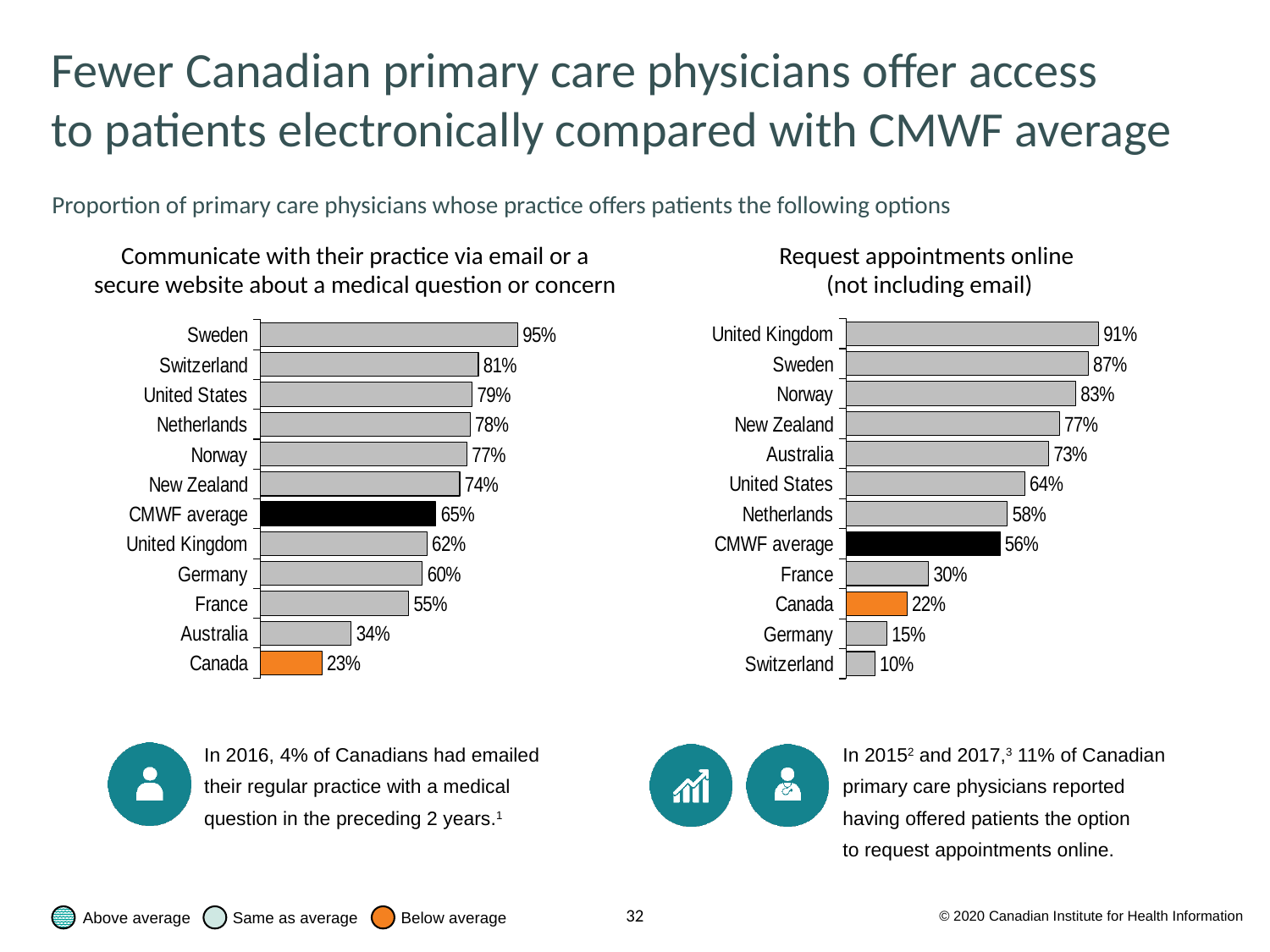
In the 'Request appointments online' chart, which is larger, the value for France or the value for Germany? France In the 'Request appointments online' chart, what colour is the bar for Canada? Orange In the 'Request appointments online' chart, which country has the lowest value? Switzerland In the 'Request appointments online' chart, what is the difference between the United Kingdom and Canada? 69 percentage points In the 'Communicate with their practice via email or a secure website' chart, what is the difference between the CMWF average and Canada? 42 percentage points What type of chart is used on the left side of the slide? Bar chart How many categories (bars) are shown in the 'Communicate with their practice via email or a secure website' chart? 12 In the 'Request appointments online' chart, which country has the highest value? United Kingdom In the 'Communicate with their practice via email or a secure website' chart, which country has the lowest value? Canada In the 'Request appointments online' chart, what is the value for the CMWF average? 56% In the 'Communicate with their practice via email or a secure website' chart, what is the value for Sweden? 95% In the 'Communicate with their practice via email or a secure website' chart, what is the value for Canada? 23%